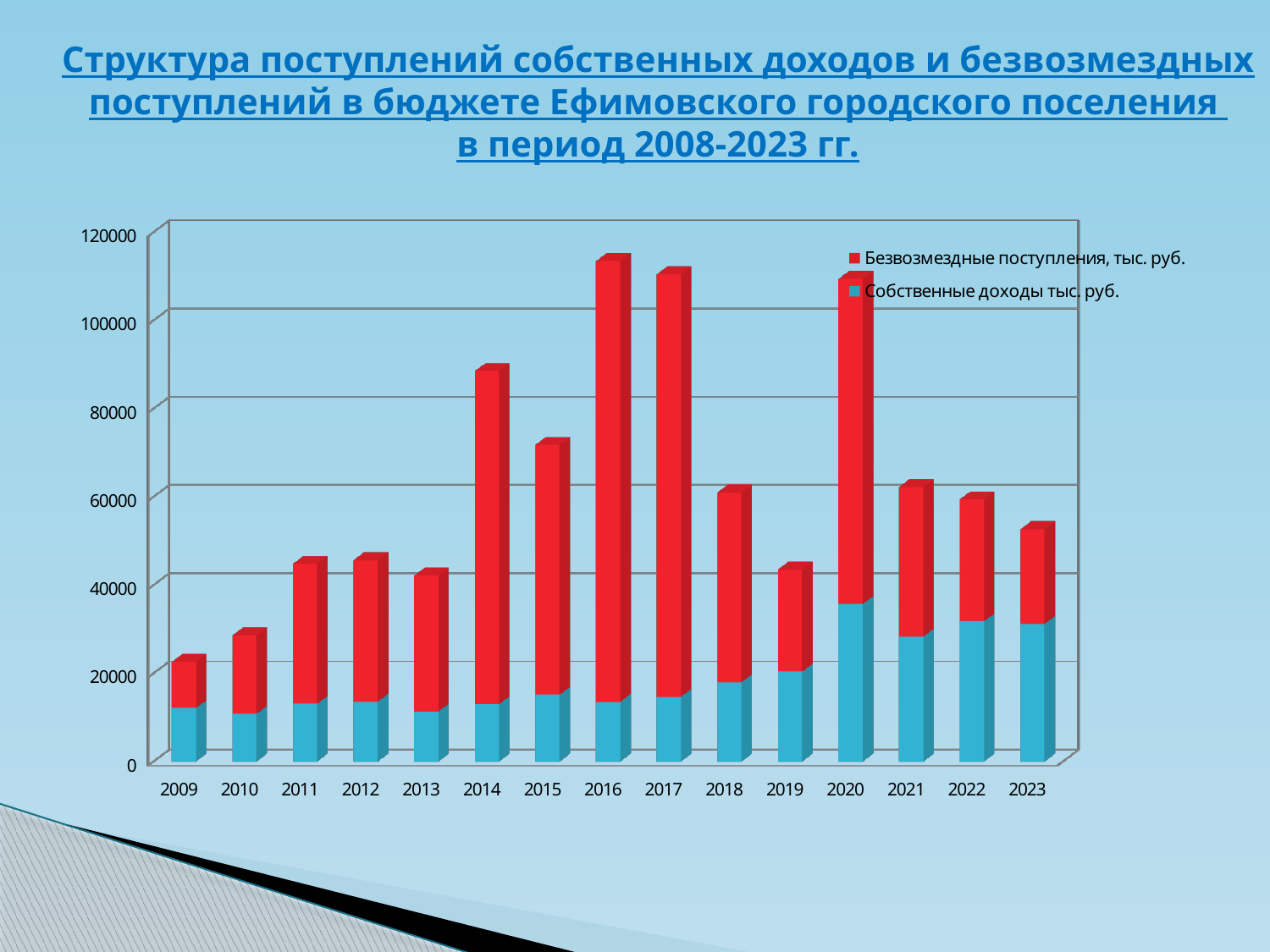
Is the total bar for 2023 greater or less than 60000? less Is the total bar for 2014 greater or less than 80000? greater Is the total bar for 2009 greater or less than 40000? less Which year has the lowest total bar in the chart? 2009 Which series is shown in red in the chart? Безвозмездные поступления, тыс. руб. Which year has the highest value for Собственные доходы тыс. руб.? 2020 What kind of chart is shown on the slide? Stacked bar chart Which year has the larger total bar, 2014 or 2015? 2014 How many series does the chart legend list? 2 How many years are shown on the x axis of the chart? 15